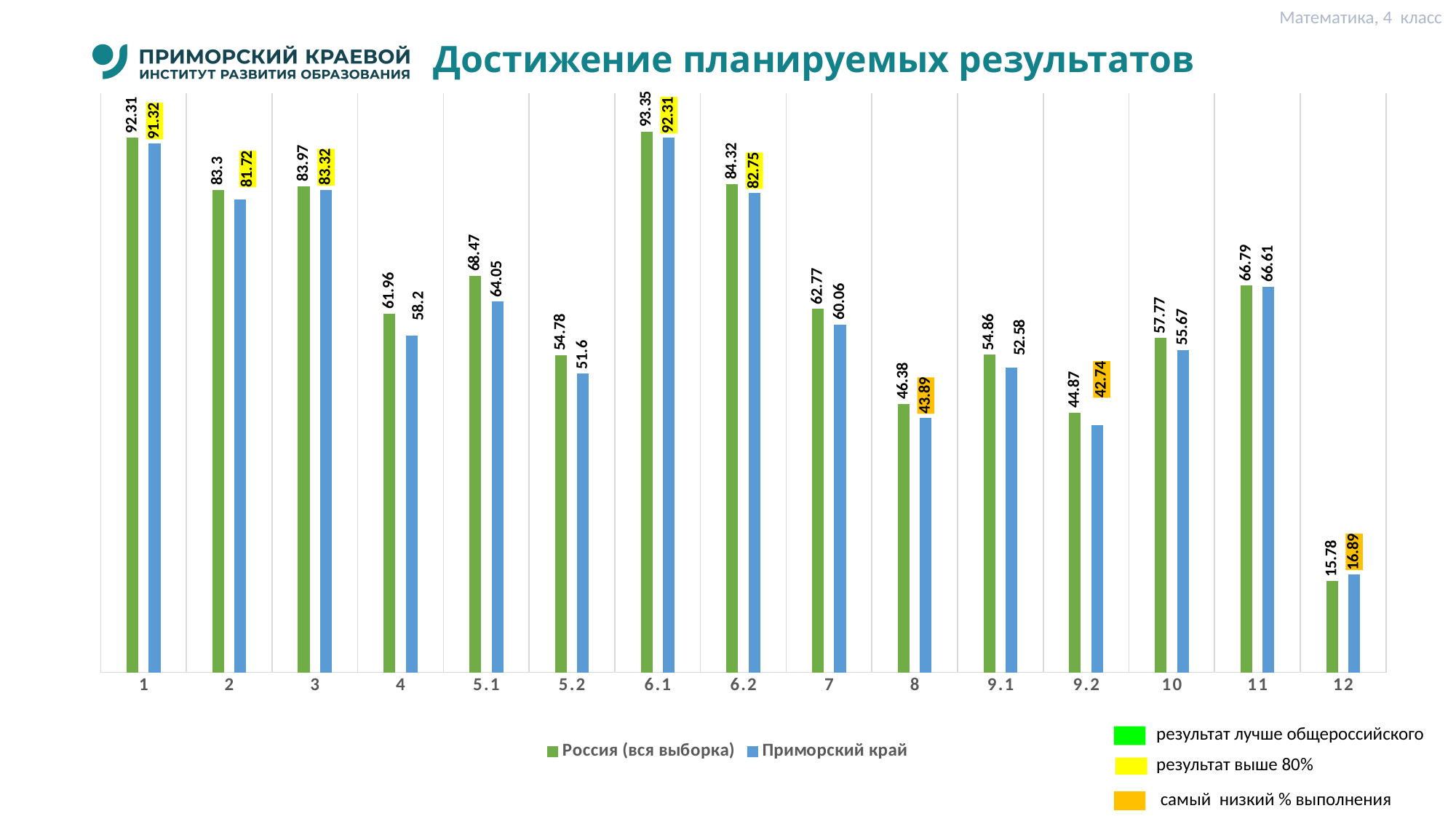
Which category has the highest value for Россия (вся выборка)? 6.1 In category 12, which series has the larger value: Россия (вся выборка) or Приморский край? Приморский край What is the value for Приморский край in category 12? 16.89 Which is larger: the Приморский край value in category 8 or in category 9.2? category 8 What is the title of the chart on the slide? Достижение планируемых результатов Which category has the lowest value for Приморский край? 12 What is the value for Россия (вся выборка) in category 4? 61.96 What is the difference between the Россия (вся выборка) and Приморский край values in category 4? 3.76 How many categories are shown along the x axis of the chart? 15 How many series does the chart legend list? 2 What is the value for Приморский край in category 6.1? 92.31 What type of chart is shown on the slide? bar chart